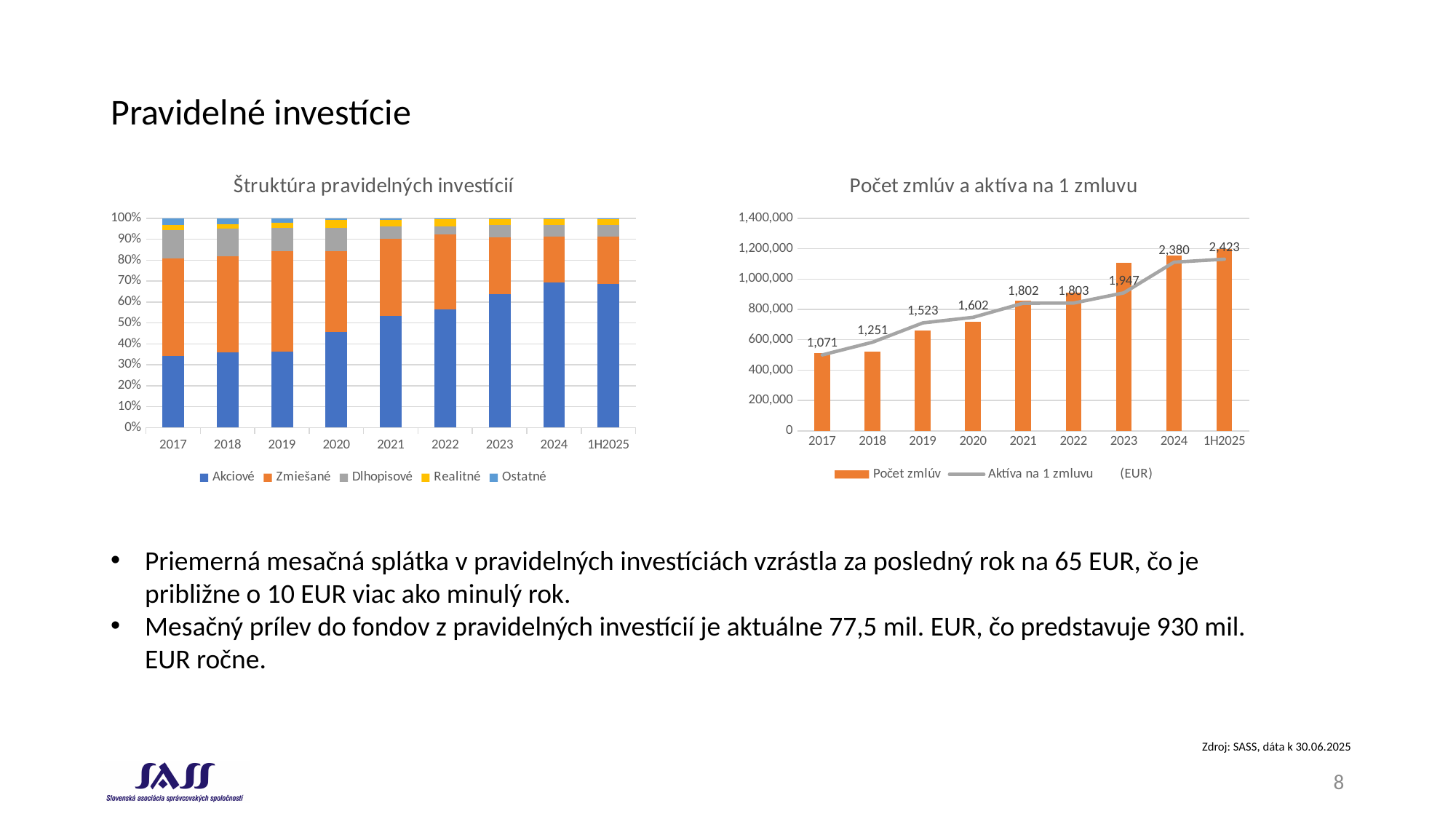
In the chart titled "Počet zmlúv a aktíva na 1 zmluvu", what is the difference in Aktíva na 1 zmluvu between 2024 and 2023? 433 In the chart titled "Počet zmlúv a aktíva na 1 zmluvu", what is the value of Aktíva na 1 zmluvu for 2017? 1,071 In the chart titled "Počet zmlúv a aktíva na 1 zmluvu", which period has the lowest Aktíva na 1 zmluvu? 2017 In the chart titled "Počet zmlúv a aktíva na 1 zmluvu", which period has the highest Aktíva na 1 zmluvu? 1H2025 What kind of chart is the chart titled "Štruktúra pravidelných investícií"? stacked bar chart In the chart titled "Počet zmlúv a aktíva na 1 zmluvu", how many periods are shown on the x axis? 9 In the chart titled "Počet zmlúv a aktíva na 1 zmluvu", which year has the larger Aktíva na 1 zmluvu, 2019 or 2020? 2020 In the chart titled "Počet zmlúv a aktíva na 1 zmluvu", is the Počet zmlúv bar for 2017 greater or less than 600,000? less In the chart titled "Počet zmlúv a aktíva na 1 zmluvu", what is the value of Aktíva na 1 zmluvu for 1H2025? 2,423 In the chart titled "Počet zmlúv a aktíva na 1 zmluvu", is the Počet zmlúv bar for 2023 greater or less than 1,000,000? greater In the chart titled "Počet zmlúv a aktíva na 1 zmluvu", does the Aktíva na 1 zmluvu line rise or fall from 2017 to 1H2025? rise In the chart titled "Štruktúra pravidelných investícií", how many series does the legend list? 5